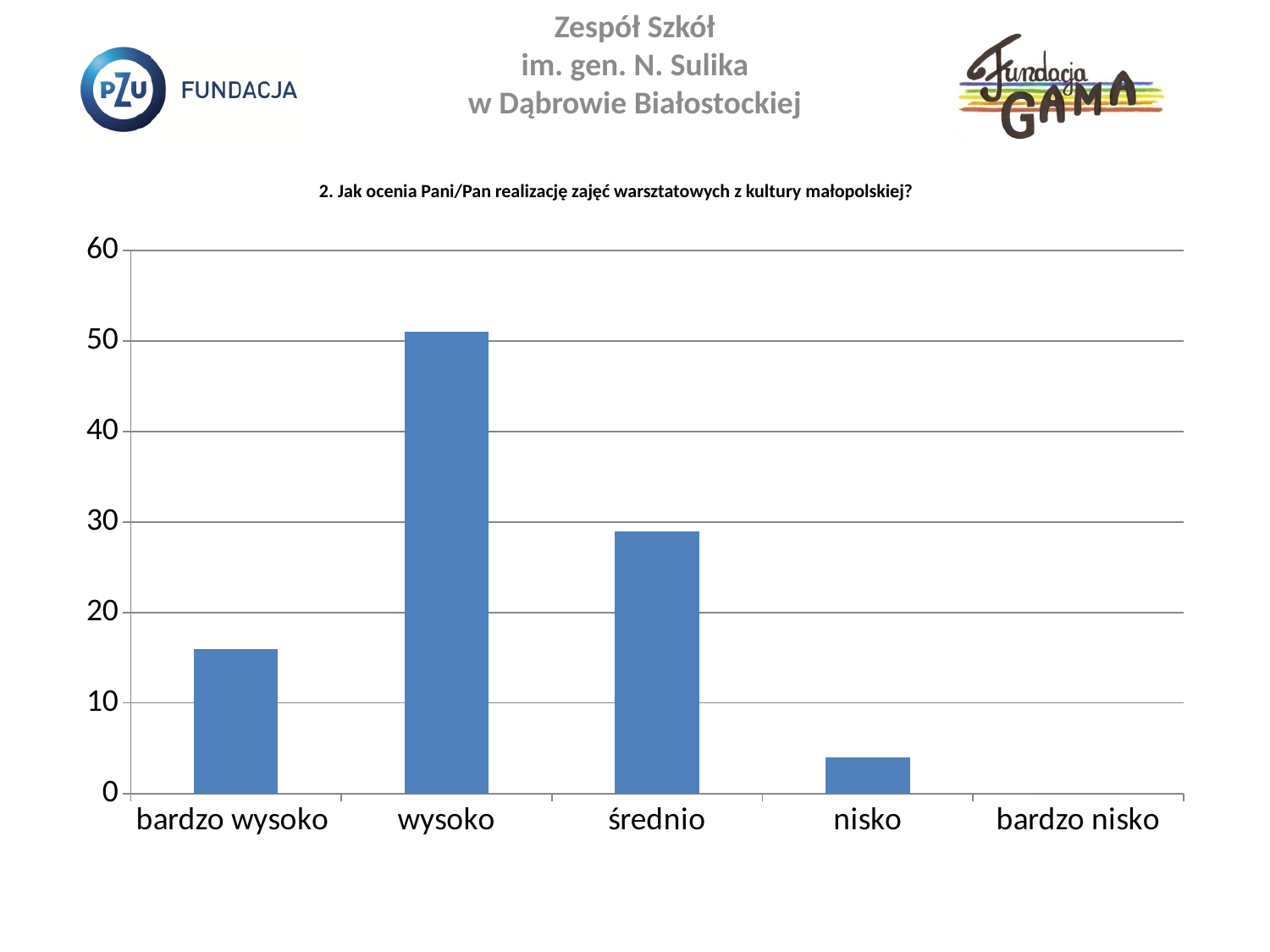
Which category has the highest value in the chart? wysoko What is the title of the chart? 2. Jak ocenia Pani/Pan realizację zajęć warsztatowych z kultury małopolskiej? Is the value for bardzo wysoko greater or less than 20? less Which has a larger value, nisko or bardzo wysoko? bardzo wysoko What kind of chart is shown on the slide? bar chart How many categories are shown on the x axis of the chart? 5 Do the values rise or fall along the x axis from wysoko to bardzo nisko? fall Which category has the lowest value in the chart? bardzo nisko Is the value for nisko greater or less than 10? less Which has a larger value, bardzo wysoko or średnio? średnio